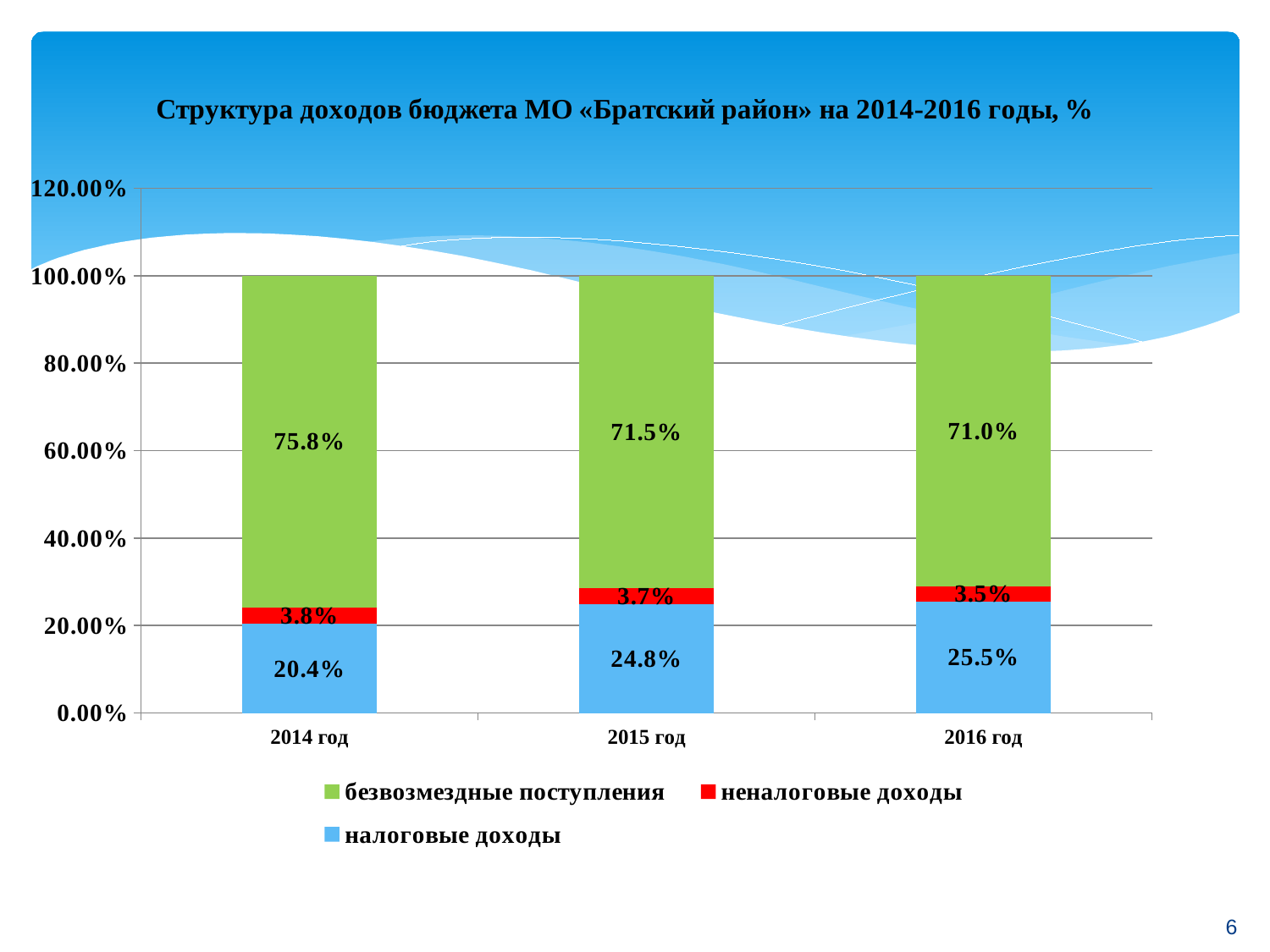
What is the value for налоговые доходы in 2016 год? 25.5% Which year has the highest value for безвозмездные поступления? 2014 год Which is larger: налоговые доходы in 2015 год or налоговые доходы in 2016 год? 2016 год What kind of chart is shown on the slide? Stacked bar chart How many series does the legend list? 3 What is the value for неналоговые доходы in 2015 год? 3.7% What is the difference between the безвозмездные поступления values for 2014 год and 2016 год? 4.8% What is the title of the chart? Структура доходов бюджета МО «Братский район» на 2014-2016 годы, % Which year has the lowest value for налоговые доходы? 2014 год How many years are shown on the x axis? 3 Do the values for налоговые доходы rise or fall from 2014 год to 2016 год? Rise What is the value for безвозмездные поступления in 2014 год? 75.8%